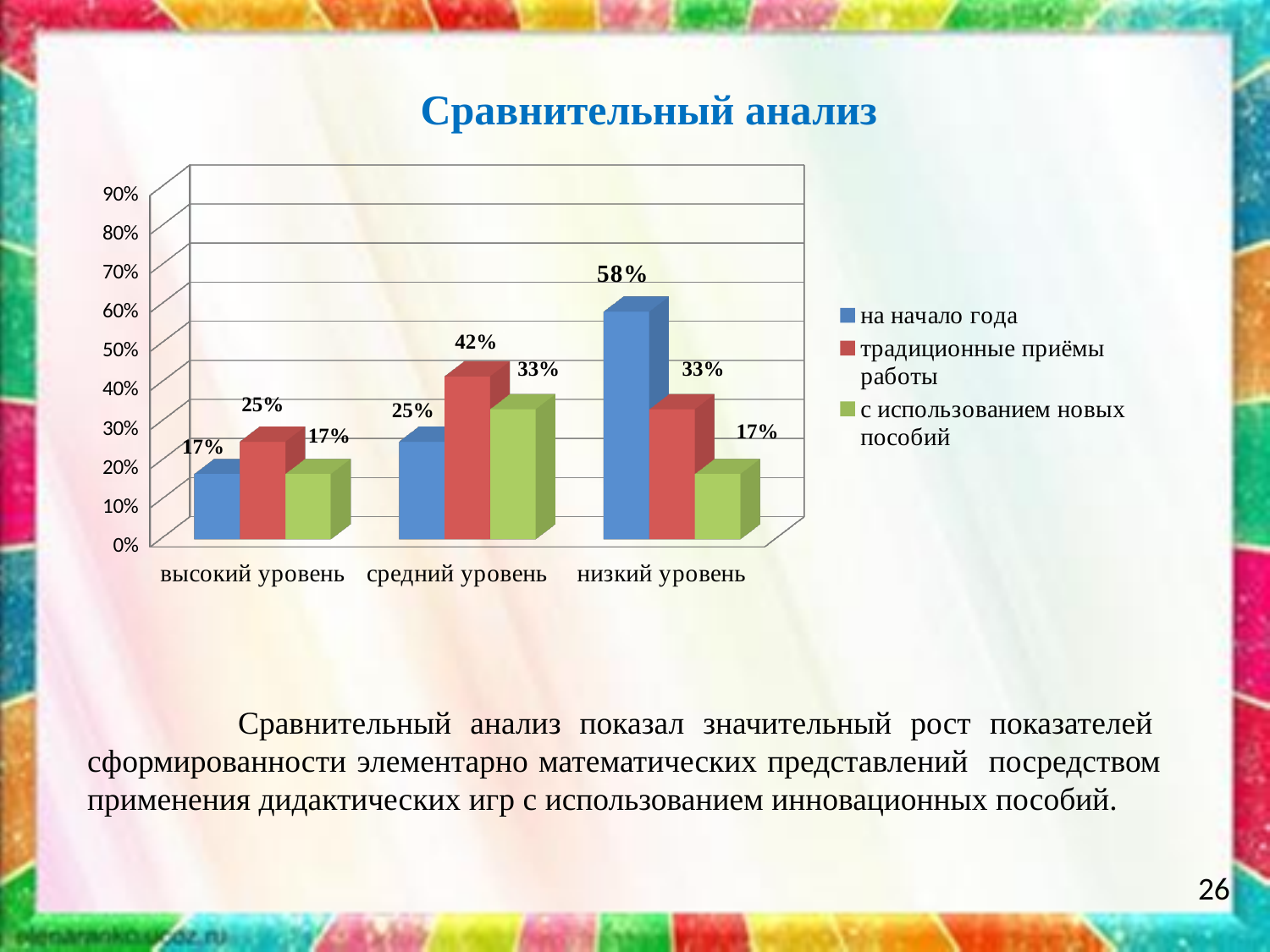
What type of chart is shown on the slide? bar chart In the 'средний уровень' category, which is larger: 'на начало года' or 'традиционные приёмы работы'? традиционные приёмы работы How many series does the legend list? 3 Which series has the lowest value in the 'низкий уровень' category? с использованием новых пособий How many categories are shown on the x axis? 3 What is the value for 'с использованием новых пособий' in the 'средний уровень' category? 33% What is the value for 'традиционные приёмы работы' in the 'средний уровень' category? 42% What is the value for 'на начало года' in the 'низкий уровень' category? 58% Which category has the highest value for the 'на начало года' series? низкий уровень What is the title of the chart? Сравнительный анализ What is the value for 'на начало года' in the 'высокий уровень' category? 17% What is the difference between 'на начало года' and 'с использованием новых пособий' in the 'низкий уровень' category? 41%